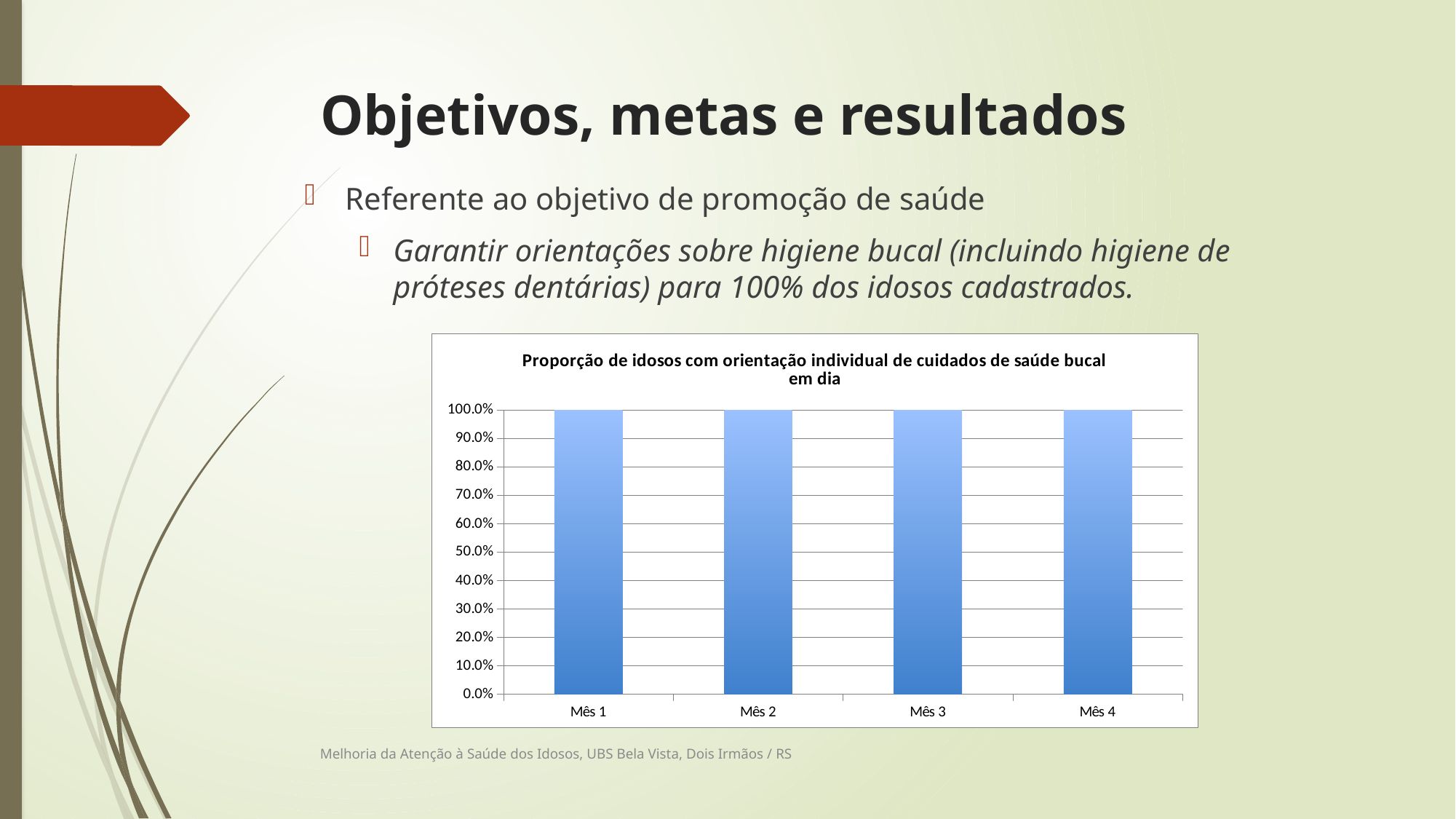
What is the value for Mês 1 in the chart? 100.0% What is the title of the chart? Proporção de idosos com orientação individual de cuidados de saúde bucal em dia What is the label of the first category on the x axis? Mês 1 Is the value for Mês 1 greater or less than 90.0%? greater Is the value for Mês 3 greater or less than 50.0%? greater What type of chart is shown on the slide? bar chart How many categories (months) are shown on the x axis of the chart? 4